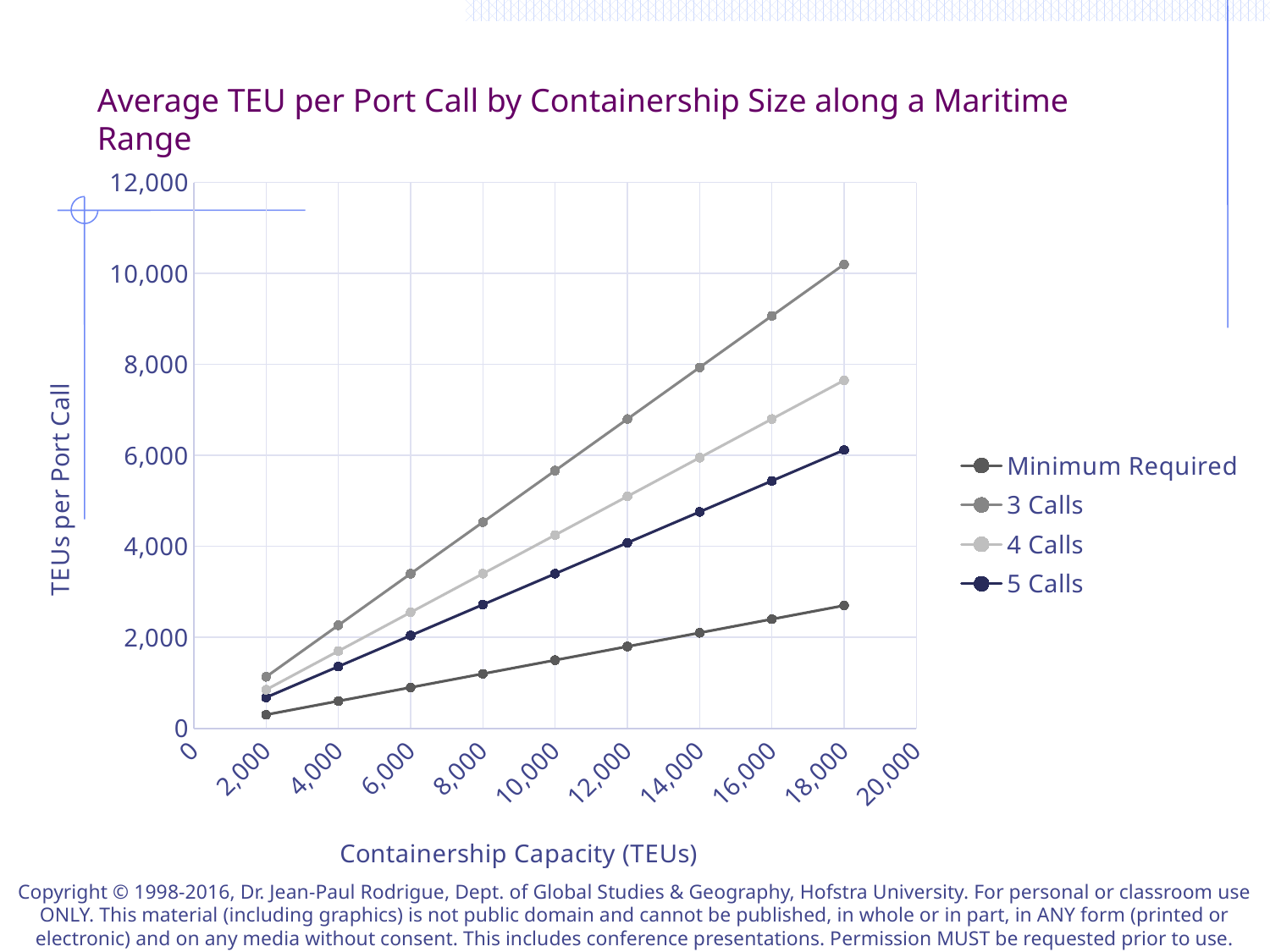
How many data points are plotted for the 3 Calls series? 9 Which series has the lowest value at a containership capacity of 18,000 TEUs? Minimum Required What kind of chart is shown on the slide? Line chart What is the label of the vertical axis? TEUs per Port Call Is the value for 5 Calls at 10,000 TEUs greater or less than 4,000? less Do the values for the 3 Calls series rise or fall as containership capacity increases? rise How many series does the legend list? 4 Is the value for 3 Calls at 18,000 TEUs greater or less than 10,000? greater At 14,000 TEUs, which is larger: the value for 4 Calls or the value for 5 Calls? 4 Calls Which series has the highest value at a containership capacity of 18,000 TEUs? 3 Calls Is the value for 4 Calls at 18,000 TEUs greater or less than 8,000? less